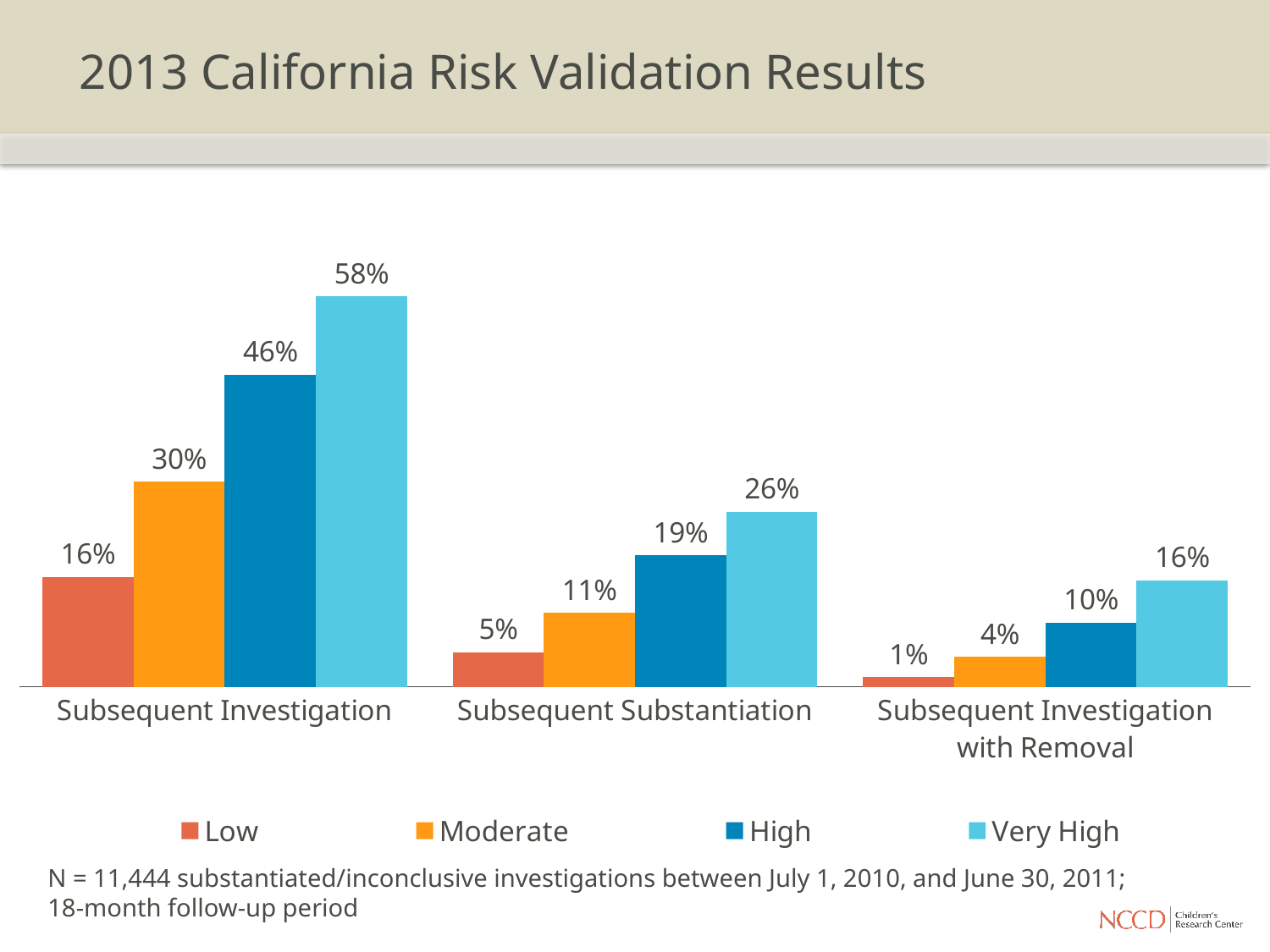
What is the value for Very High in the Subsequent Investigation category? 58% Within each category, do the values rise or fall from Low to Very High? Rise What is the value for Moderate in the Subsequent Investigation with Removal category? 4% Which risk level has the lowest value in the Subsequent Investigation with Removal category? Low How many categories are shown on the x axis? 3 Which is larger: the High value for Subsequent Substantiation or the Very High value for Subsequent Investigation with Removal? High value for Subsequent Substantiation What is the title of the slide? 2013 California Risk Validation Results What kind of chart is shown on the slide? Bar chart What is the value for Low in the Subsequent Substantiation category? 5% How many series does the legend list? 4 Which risk level has the highest value in the Subsequent Substantiation category? Very High What is the difference between the Very High and Low values in the Subsequent Investigation category? 42%